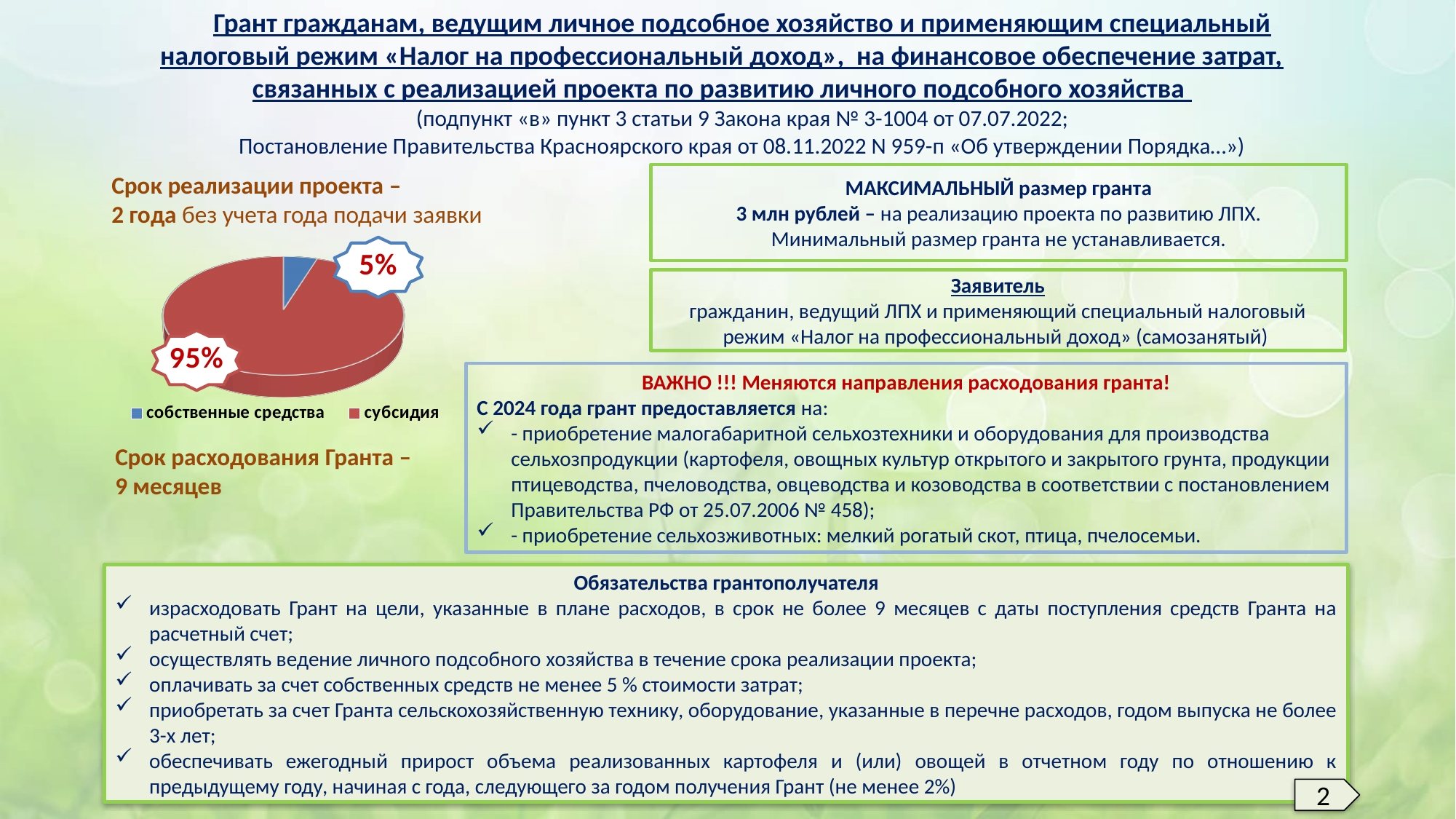
What share of the pie chart does "субсидия" represent? 95% What is the difference in percentage points between the "субсидия" slice and the "собственные средства" slice? 90 What is the total of the two slices shown in the pie chart? 100% What colour is the "собственные средства" slice in the pie chart? blue How many entries does the pie chart's legend list? 2 What kind of chart is shown on the slide? pie chart What colour is the "субсидия" slice in the pie chart? red What share of the pie chart does "собственные средства" represent? 5% Which slice of the pie chart is the largest? субсидия How many slices does the pie chart have? 2 Which is larger in the pie chart: "собственные средства" or "субсидия"? субсидия Which slice of the pie chart is the smallest? собственные средства